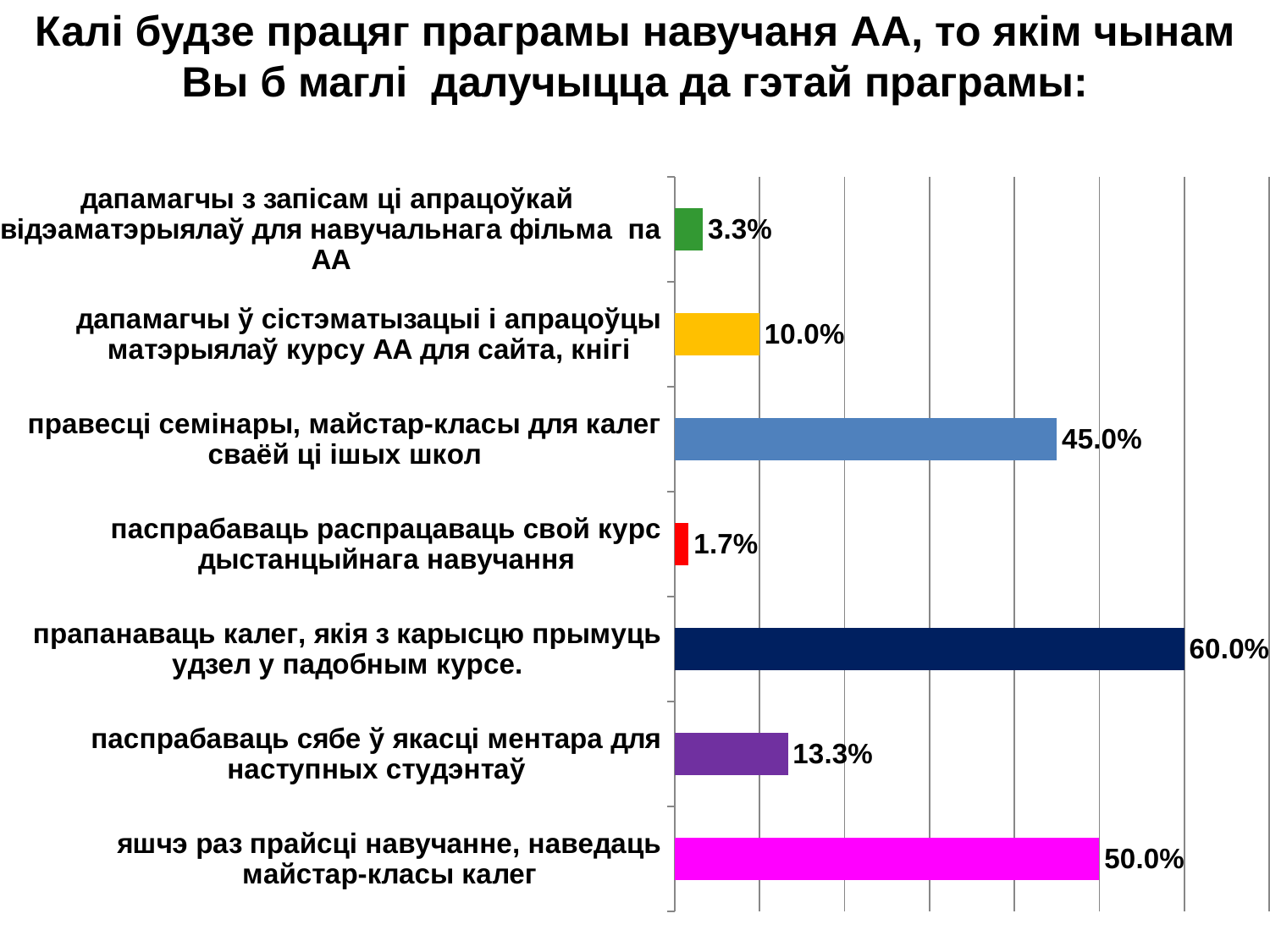
Which category has the highest value? прапанаваць калег, якія з карысцю прымуць удзел у падобным курсе. Which category has the lowest value? паспрабаваць распрацаваць свой курс дыстанцыйнага навучання What is the value for "прапанаваць калег, якія з карысцю прымуць удзел у падобным курсе."? 60.0% What kind of chart is shown on the slide? bar chart What is the value for "яшчэ раз прайсці навучанне, наведаць майстар-класы калег"? 50.0% What is the value for "паспрабаваць сябе ў якасці ментара для наступных студэнтаў"? 13.3% What is the difference between the values for "дапамагчы з запісам ці апрацоўкай відэаматэрыялаў для навучальнага фільма па АА" and "паспрабаваць распрацаваць свой курс дыстанцыйнага навучання"? 1.6% How many categories are plotted in the chart? 7 Which is larger: the value for "дапамагчы ў сістэматызацыі і апрацоўцы матэрыялаў курсу АА для сайта, кнігі" or for "паспрабаваць сябе ў якасці ментара для наступных студэнтаў"? паспрабаваць сябе ў якасці ментара для наступных студэнтаў What colour is the bar for "яшчэ раз прайсці навучанне, наведаць майстар-класы калег"? magenta What is the value for "правесці семінары, майстар-класы для калег сваёй ці ішых школ"? 45.0% What is the difference between the values for "прапанаваць калег, якія з карысцю прымуць удзел у падобным курсе." and "яшчэ раз прайсці навучанне, наведаць майстар-класы калег"? 10.0%